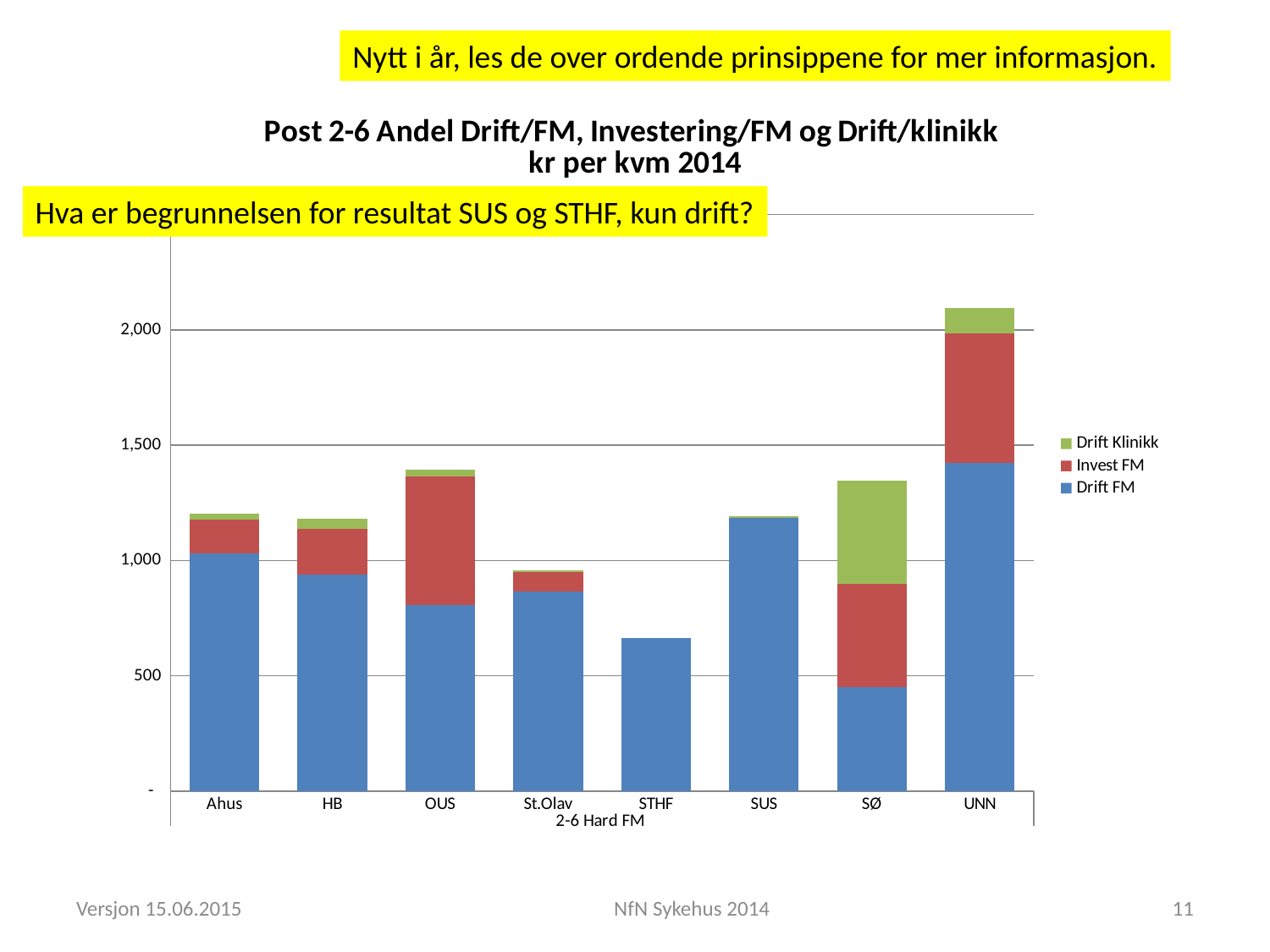
Is the Drift FM value for SØ greater or less than 500? less How many categories are shown along the x axis of the chart? 8 How many series does the chart's legend list? 3 Which series is shown in blue in the chart? Drift FM Which category has the highest total bar in the chart? UNN Which category has the largest Drift Klinikk segment? SØ What is the title of the chart? Post 2-6 Andel Drift/FM, Investering/FM og Drift/klinikk kr per kvm 2014 Which category has the lowest total bar in the chart? STHF Which category has the larger total bar, SUS or STHF? SUS Is the total value for STHF greater or less than 1,000? less Is the total value for UNN greater or less than 2,000? greater What kind of chart is shown on the slide? Stacked bar chart